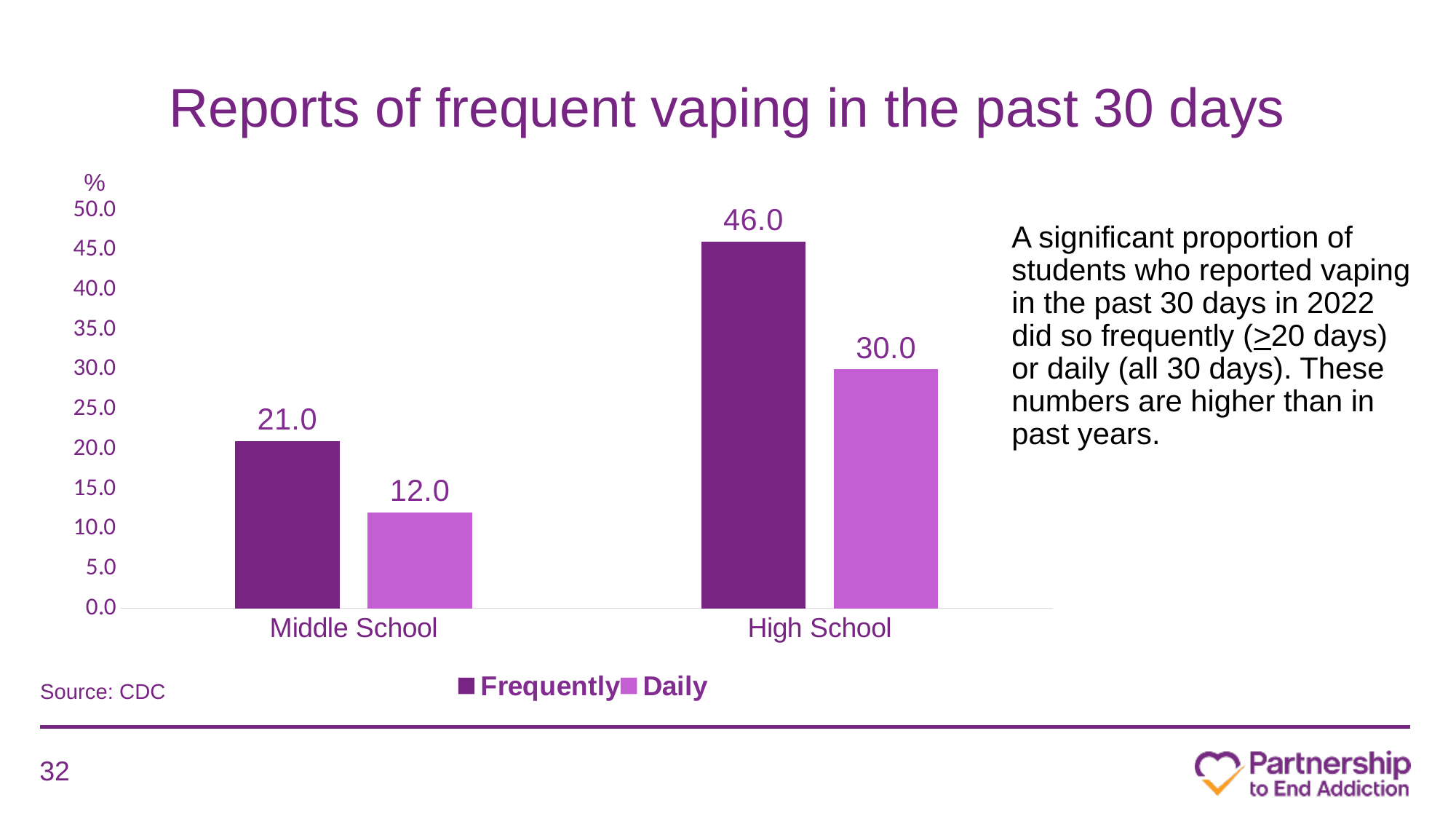
What is the value for Daily in the Middle School category? 12.0 Which category has the lowest Daily value? Middle School How many categories are shown on the x axis? 2 How many series does the legend list? 2 What is the value for Daily in the High School category? 30.0 What kind of chart is shown on the slide? Bar chart Which category has the highest Frequently value? High School What is the title of the chart? Reports of frequent vaping in the past 30 days What is the value for Frequently in the High School category? 46.0 What is the value for Frequently in the Middle School category? 21.0 What is the difference between the Frequently and Daily values for High School? 16.0 Which is larger: the Daily value for High School or the Frequently value for Middle School? Daily value for High School